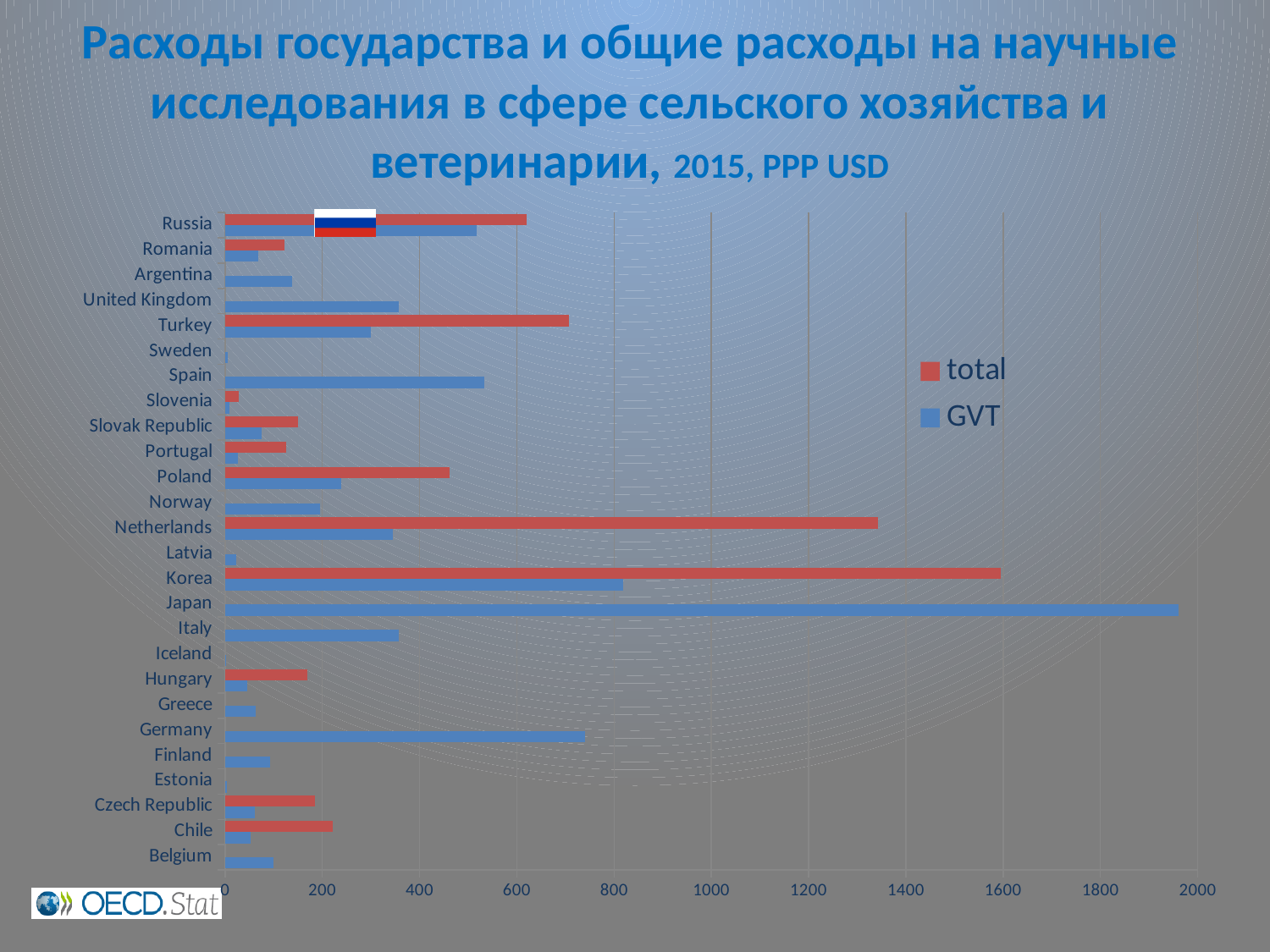
How many countries are listed on the chart? 26 Is the total value for Netherlands greater or less than 1200? greater Which is larger, the total value for Turkey or the total value for Poland? Turkey What kind of chart is shown on the slide? bar chart Is the GVT value for Russia greater or less than 600? less How many series does the legend list? 2 Is the GVT value for Germany greater or less than 600? greater Which country has the highest total value? Korea Which country has the highest GVT value? Japan What are the two series named in the legend? total and GVT Which colour represents the GVT series? blue